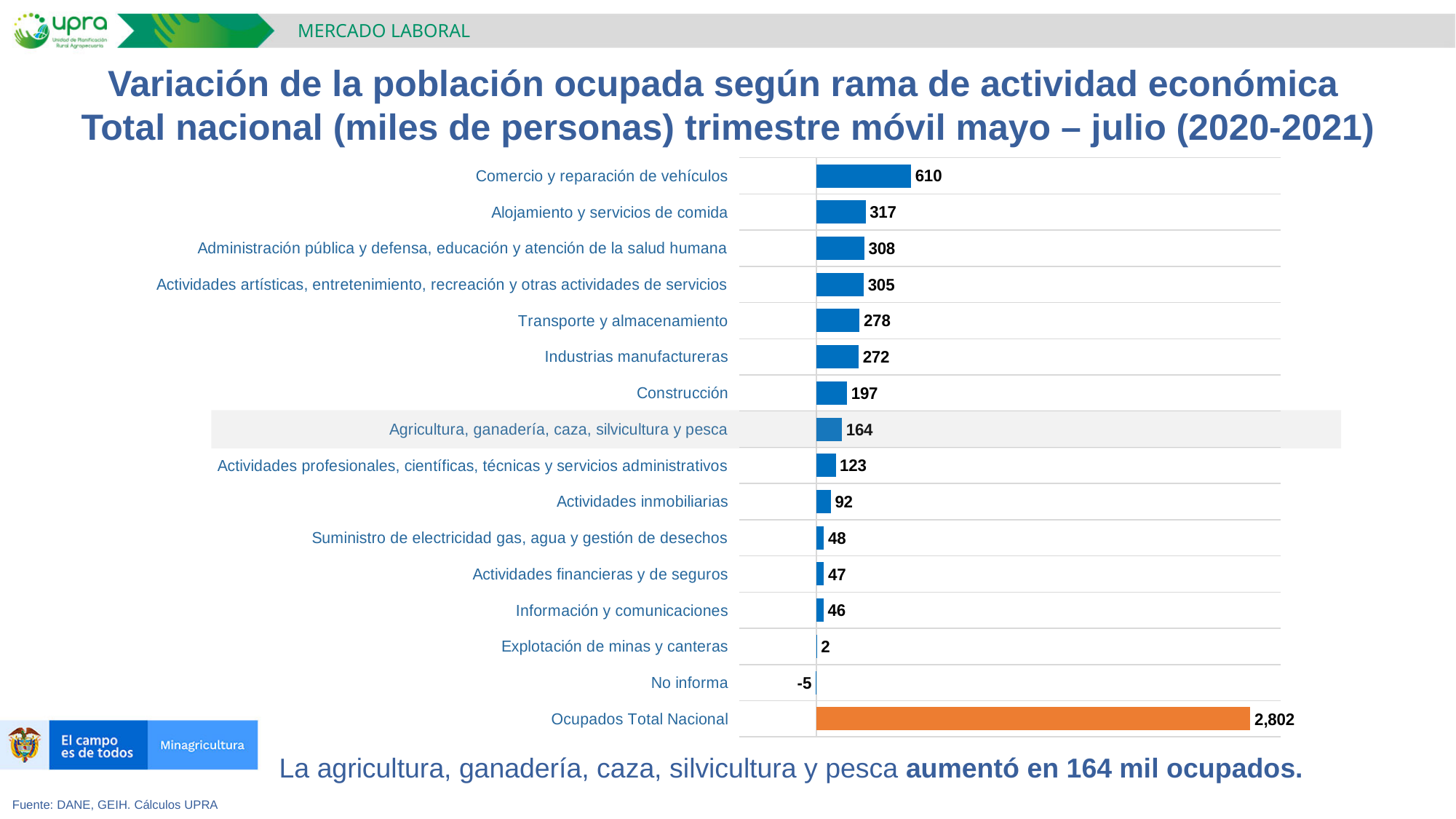
What kind of chart is shown on the slide? Bar chart What is the value for Comercio y reparación de vehículos? 610 Excluding Ocupados Total Nacional, which category has the highest value? Comercio y reparación de vehículos What is the value for Ocupados Total Nacional? 2,802 How many categories are shown in the chart? 16 What is the difference between the values for Comercio y reparación de vehículos and Alojamiento y servicios de comida? 293 Which is larger, the value for Construcción or the value for Industrias manufactureras? Industrias manufactureras What is the value for Agricultura, ganadería, caza, silvicultura y pesca? 164 What is the difference between the values for Transporte y almacenamiento and Actividades inmobiliarias? 186 Which category has the lowest value? No informa Which bar is shown in orange rather than blue? Ocupados Total Nacional What is the value for No informa? -5